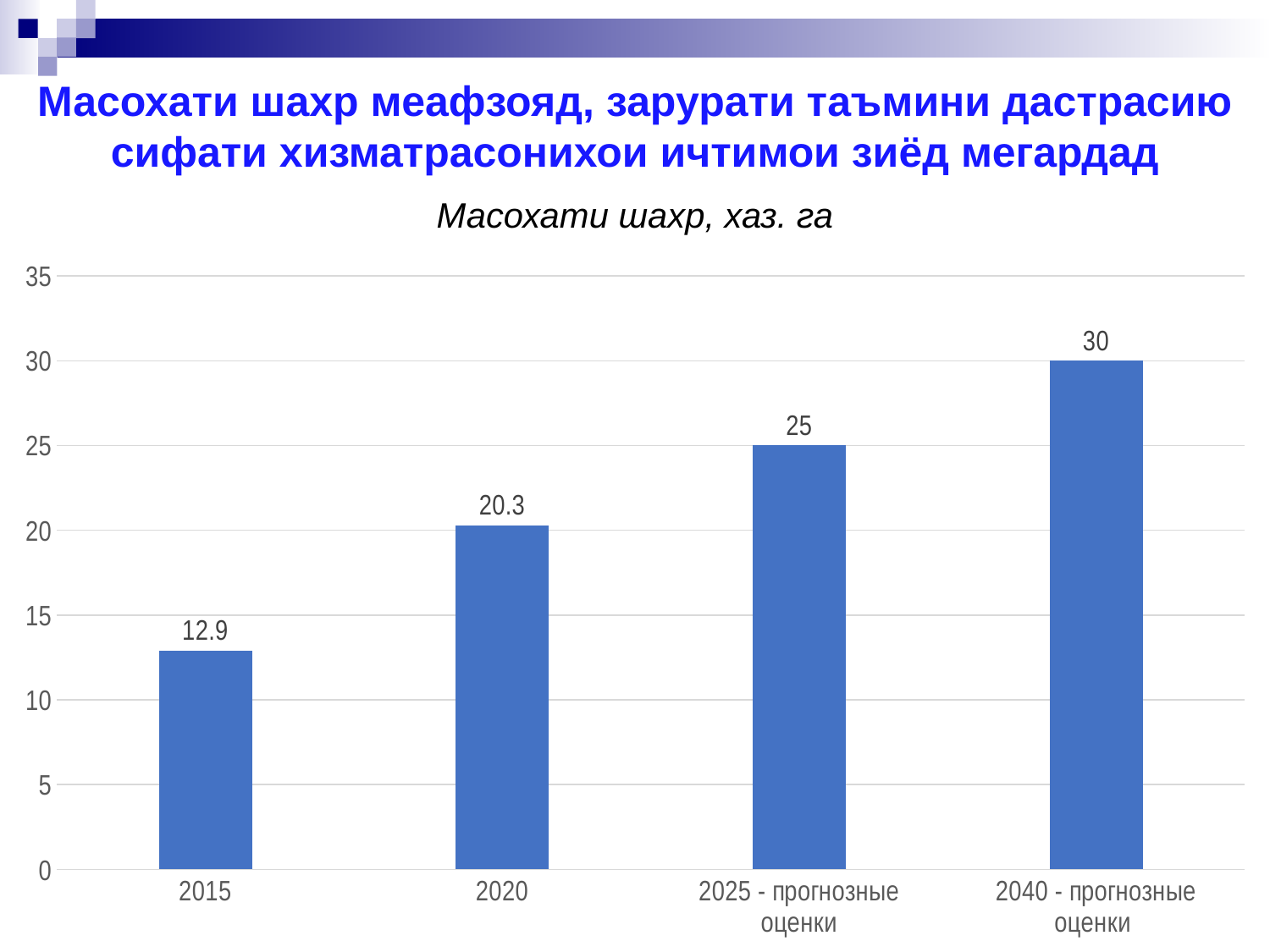
What is the value for 2025 - прогнозные оценки? 25 What is the difference between the values for 2040 - прогнозные оценки and 2025 - прогнозные оценки? 5 Which is larger, the value for 2020 or the value for 2025 - прогнозные оценки? 2025 - прогнозные оценки What is the value for 2015? 12.9 Which category has the highest value? 2040 - прогнозные оценки How many categories are shown on the x axis? 4 Which category has the lowest value? 2015 What is the value for 2020? 20.3 Do the values rise or fall from 2015 to 2040? rise What is the value for 2040 - прогнозные оценки? 30 What is the difference between the values for 2020 and 2015? 7.4 What kind of chart is this? bar chart